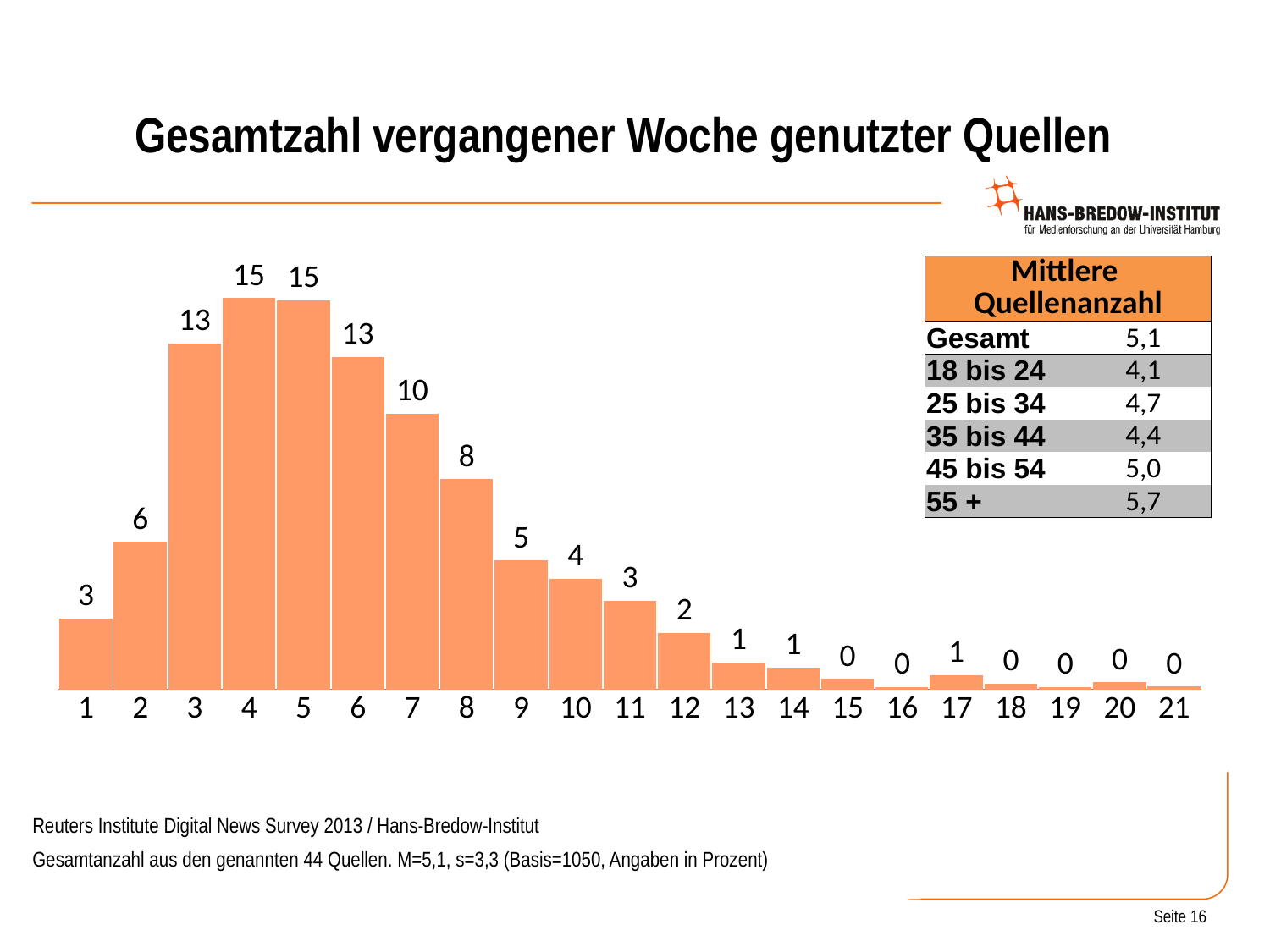
What is the value for category 12 in the chart? 2 Which has the larger value, category 6 or category 10? category 6 What is the value for category 7 in the chart? 10 What is the value for category 17 in the chart? 1 Which two categories share the highest value in the chart? 4 and 5 Which has the larger value, category 2 or category 9? category 2 What kind of chart is shown on the slide? bar chart How many categories are shown on the x axis of the chart? 21 Do the values rise or fall from category 5 to category 12? fall What is the value for category 3 in the chart? 13 What is the difference between the value for category 4 and the value for category 1? 12 What is the difference between the value for category 8 and the value for category 11? 5